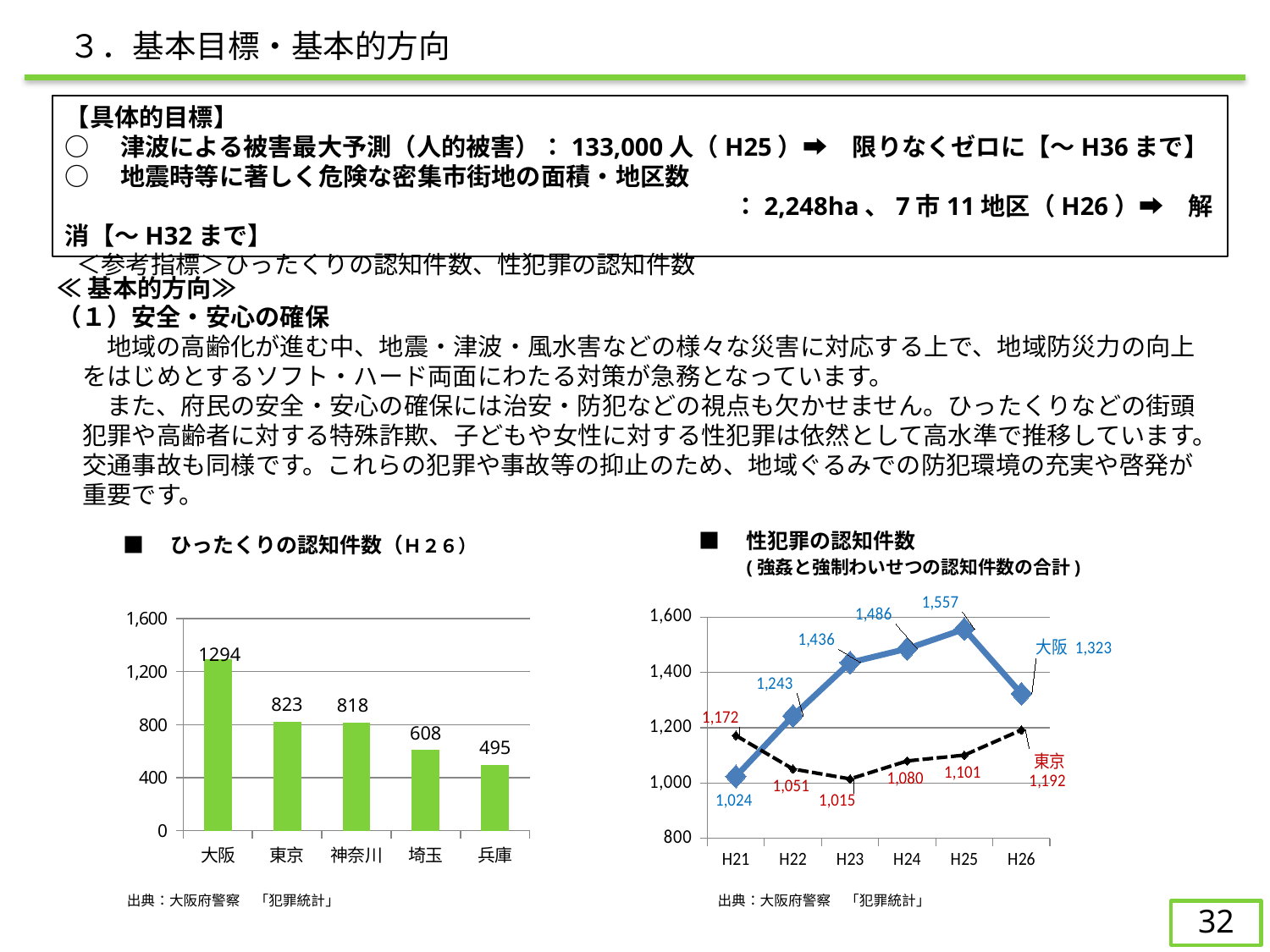
In the ひったくりの認知件数（H26） chart, which prefecture has the lowest value? 兵庫 In the ひったくりの認知件数（H26） chart, what is the value for 埼玉? 608 In the ひったくりの認知件数（H26） chart, what is the value for 大阪? 1294 What kind of chart is the ひったくりの認知件数（H26） chart? bar chart In the 性犯罪の認知件数 chart, what is the difference between 大阪 and 東京 in H26? 131 In the 性犯罪の認知件数 chart, which year has the highest value for 大阪? H25 In the 性犯罪の認知件数 chart, which is larger in H21, 大阪 or 東京? 東京 In the ひったくりの認知件数（H26） chart, how many prefectures are shown? 5 In the 性犯罪の認知件数 chart, what is the value for 大阪 in H25? 1,557 In the ひったくりの認知件数（H26） chart, what is the difference between 大阪 and 東京? 471 What kind of chart is the 性犯罪の認知件数 chart? line chart In the 性犯罪の認知件数 chart, what is the value for 東京 in H23? 1,015